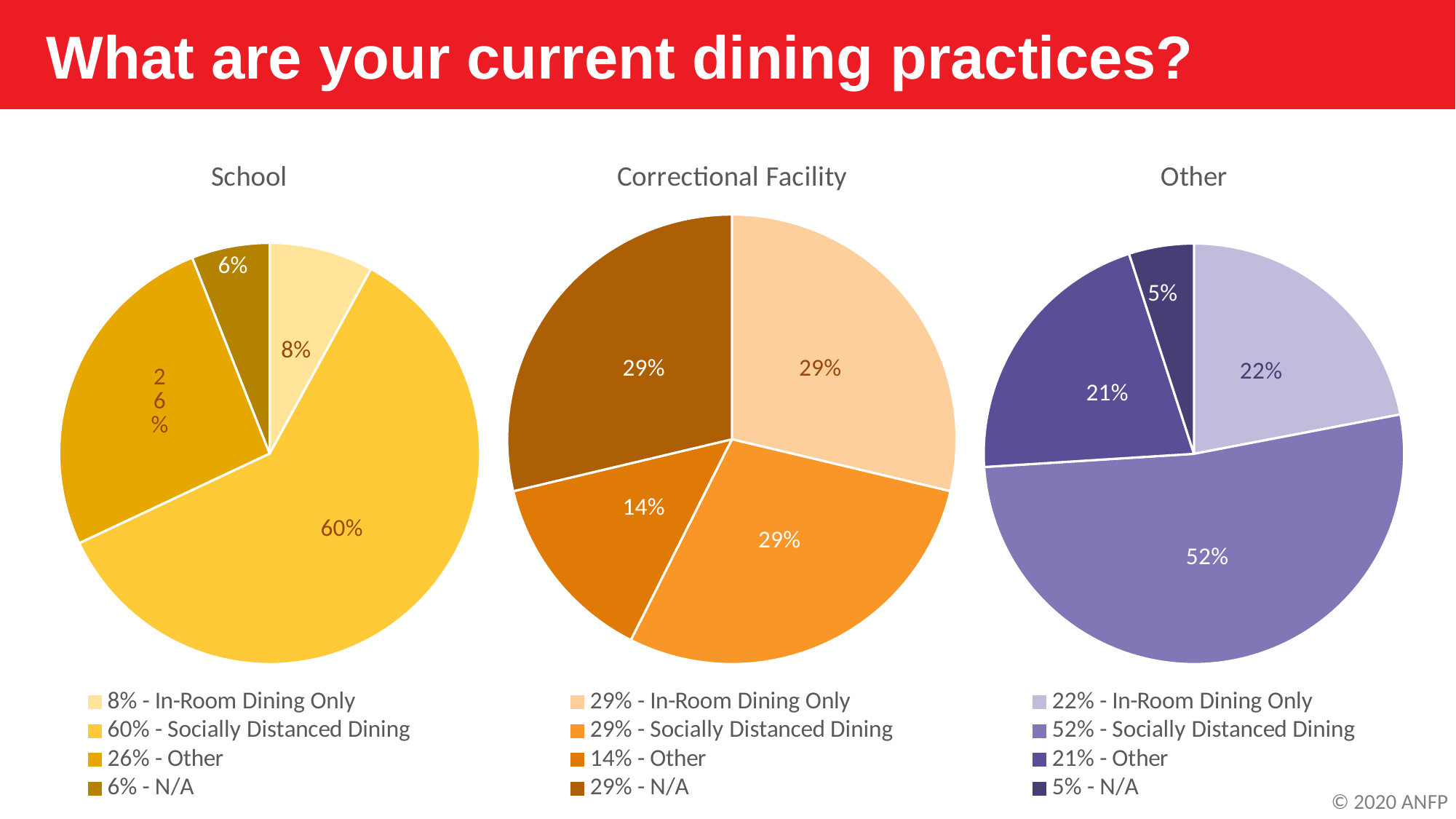
In the Other pie chart, what share is N/A? 5% In the Correctional Facility pie chart, which category has the smallest slice? Other In the Other pie chart, which category has the largest slice? Socially Distanced Dining In the School pie chart, which category has the smallest slice? N/A In the School pie chart, what share is Socially Distanced Dining? 60% How many pie charts are shown on the slide? 3 In the Other pie chart, what is the difference between Socially Distanced Dining and In-Room Dining Only? 30% In the School pie chart, which is larger: In-Room Dining Only or Other? Other In the School pie chart, what share is Other? 26% How many slices does the Correctional Facility pie chart have? 4 What type of chart is used for the School data? Pie chart